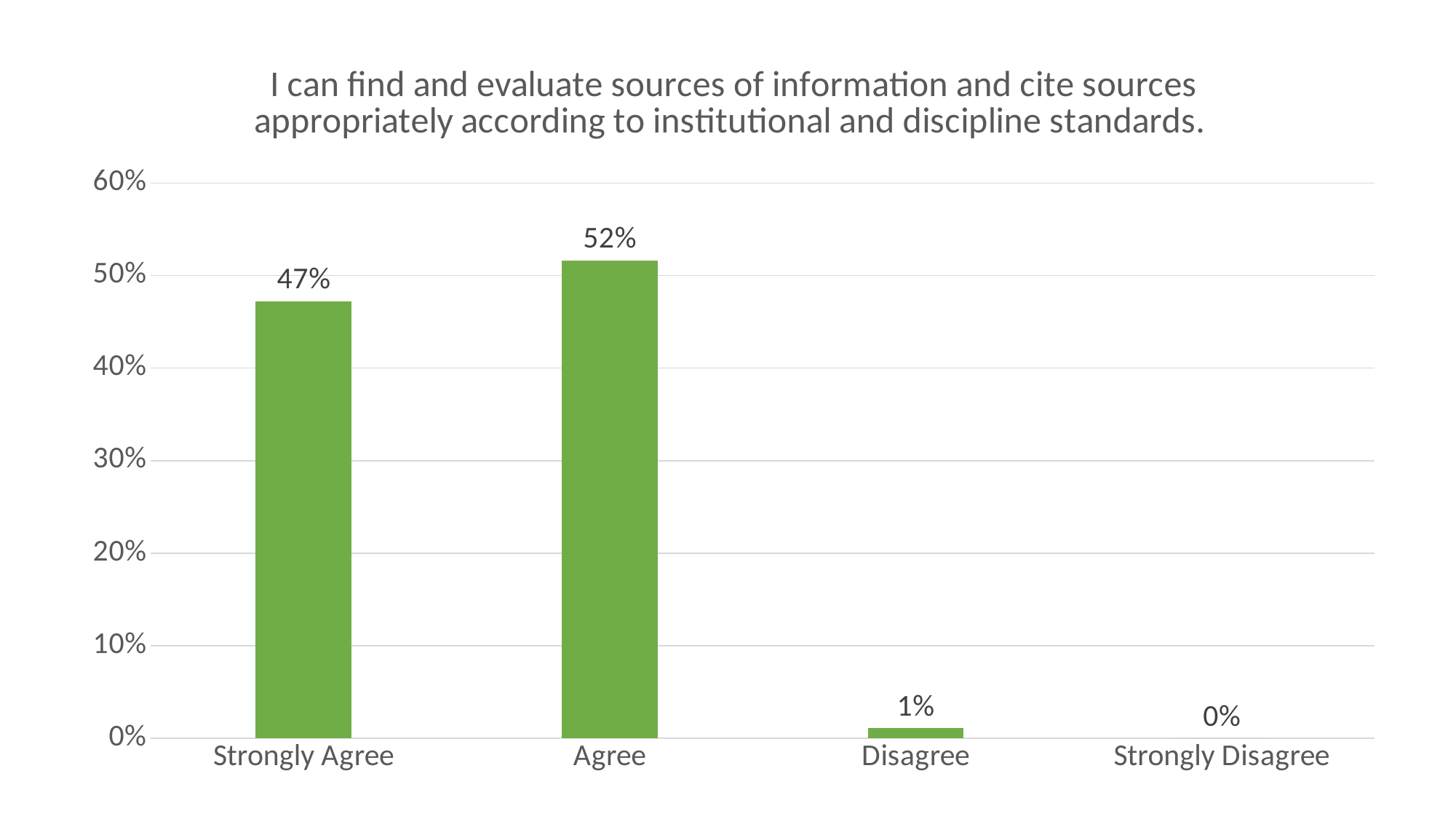
How many response categories are shown on the x axis? 4 What percentage of respondents chose Agree? 52% What kind of chart is shown on the slide? Bar chart What percentage of respondents chose Strongly Disagree? 0% What is the difference in percentage points between Agree and Strongly Agree? 5% Which is larger, the value for Strongly Agree or the value for Disagree? Strongly Agree Which response category has the lowest percentage? Strongly Disagree What is the highest value shown on the y axis? 60% What percentage of respondents chose Disagree? 1% Which response category has the highest percentage? Agree Is the value for Agree greater or less than 50%? greater What percentage of respondents chose Strongly Agree? 47%